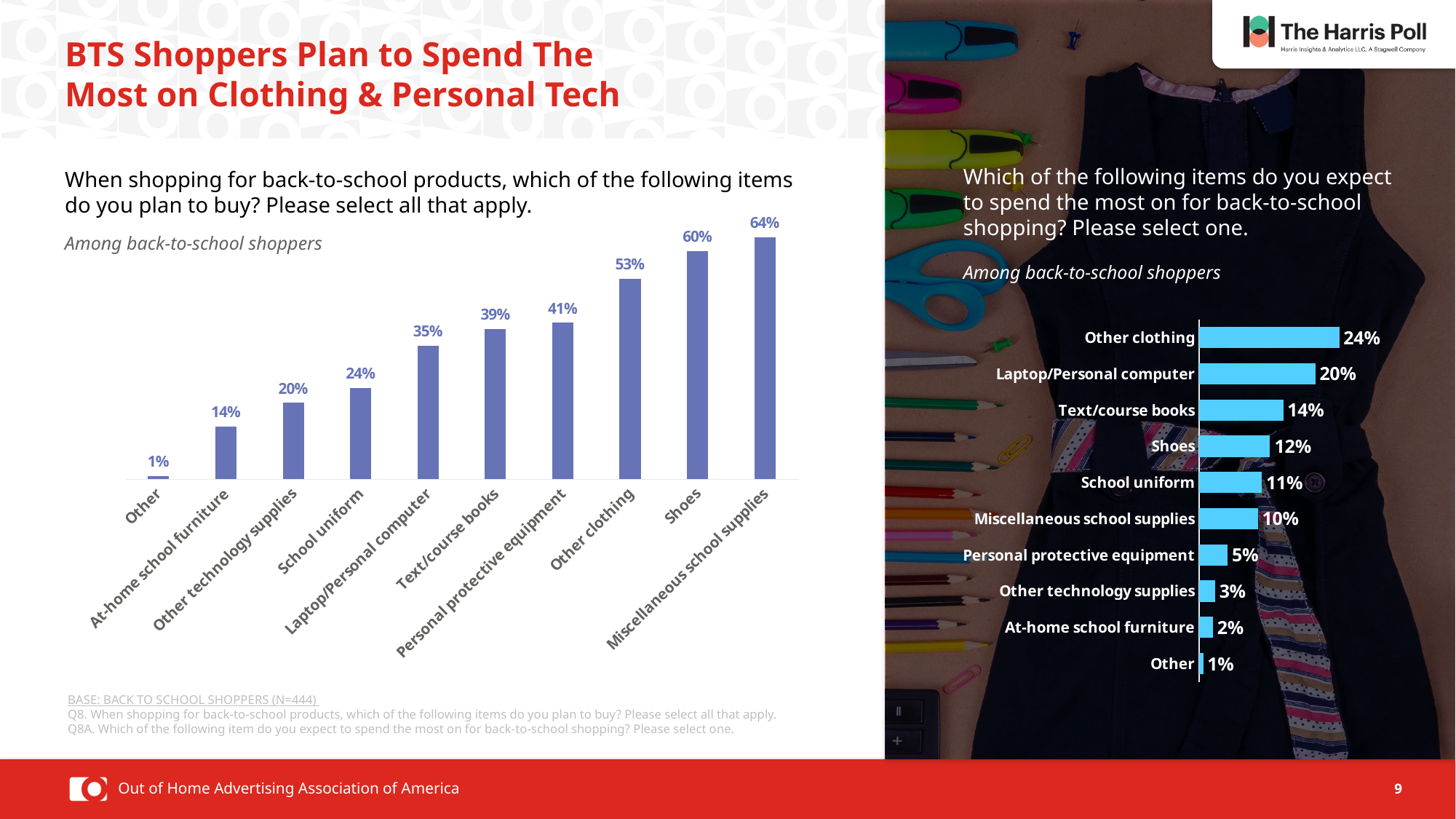
In the left chart (items planned to buy), which category has the highest value? Miscellaneous school supplies In the right chart (item expected to spend the most on), which category has the highest value? Other clothing In the left chart (items planned to buy), what is the difference between Other clothing and Laptop/Personal computer? 18 percentage points What type of chart is the right chart (item expected to spend the most on)? Bar chart In the left chart (items planned to buy), what percentage of back-to-school shoppers plan to buy Shoes? 60% In the right chart (item expected to spend the most on), what percentage selected Laptop/Personal computer? 20% In the left chart (items planned to buy), how many categories are shown? 10 In the left chart (items planned to buy), do the values rise or fall from left to right? Rise In the right chart (item expected to spend the most on), which is larger: Shoes or School uniform? Shoes In the right chart (item expected to spend the most on), what is the difference between Text/course books and Personal protective equipment? 9 percentage points In the left chart (items planned to buy), which category has the lowest value? Other What is the base size (N) stated for the charts on the slide? N=444